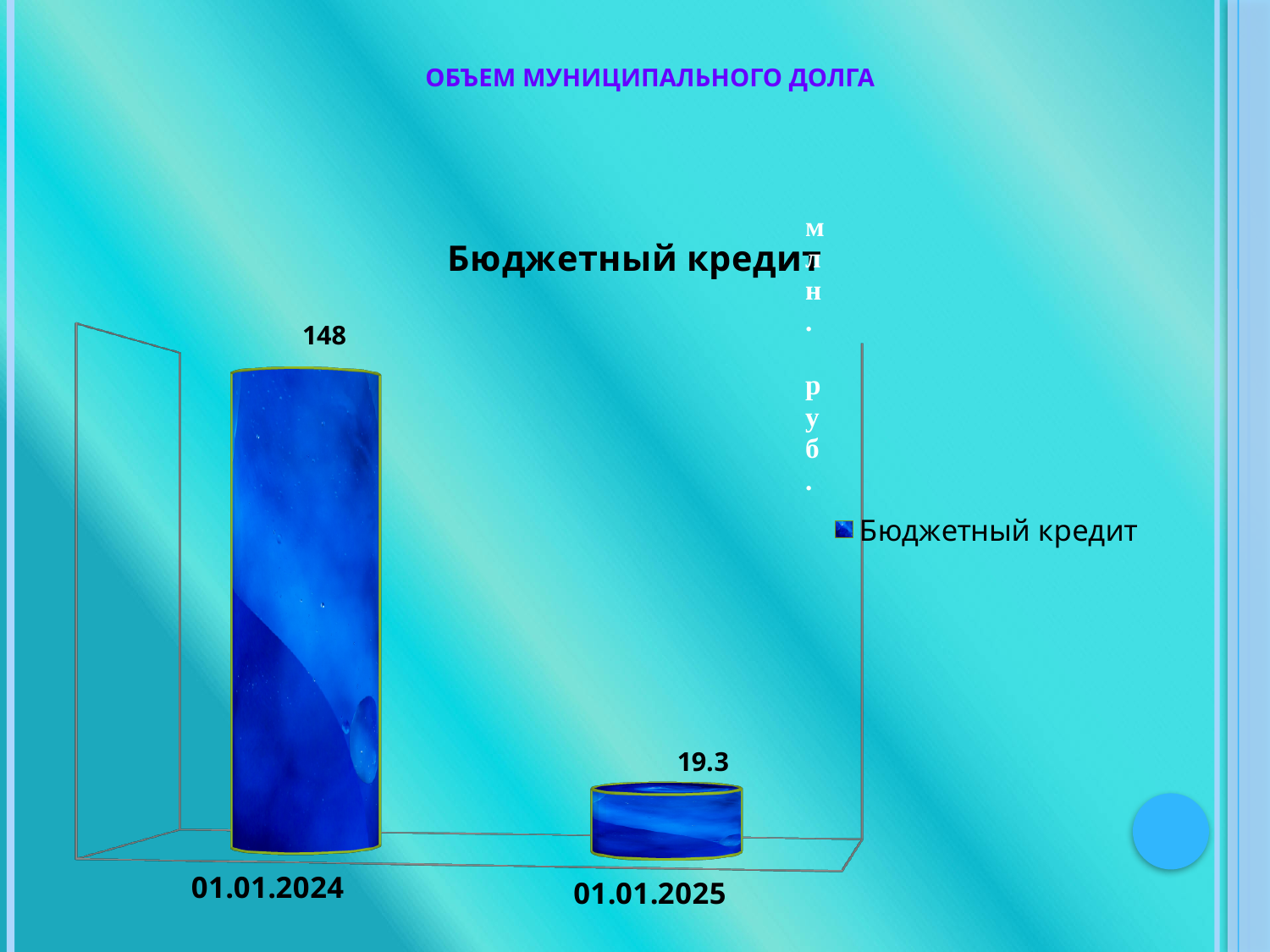
How many categories are shown on the x axis? 2 What is the value for 01.01.2024 in the chart? 148 What series name is listed in the legend? Бюджетный кредит What is the value for 01.01.2025 in the chart? 19.3 Which is larger, the value for 01.01.2024 or for 01.01.2025? 01.01.2024 Do the values rise or fall from 01.01.2024 to 01.01.2025? fall What kind of chart is shown on the slide? bar chart What is the difference between the values for 01.01.2024 and 01.01.2025? 128.7 How many series does the legend list? 1 What is the title of the chart? Бюджетный кредит Which category has the highest value? 01.01.2024 Which category has the lowest value? 01.01.2025